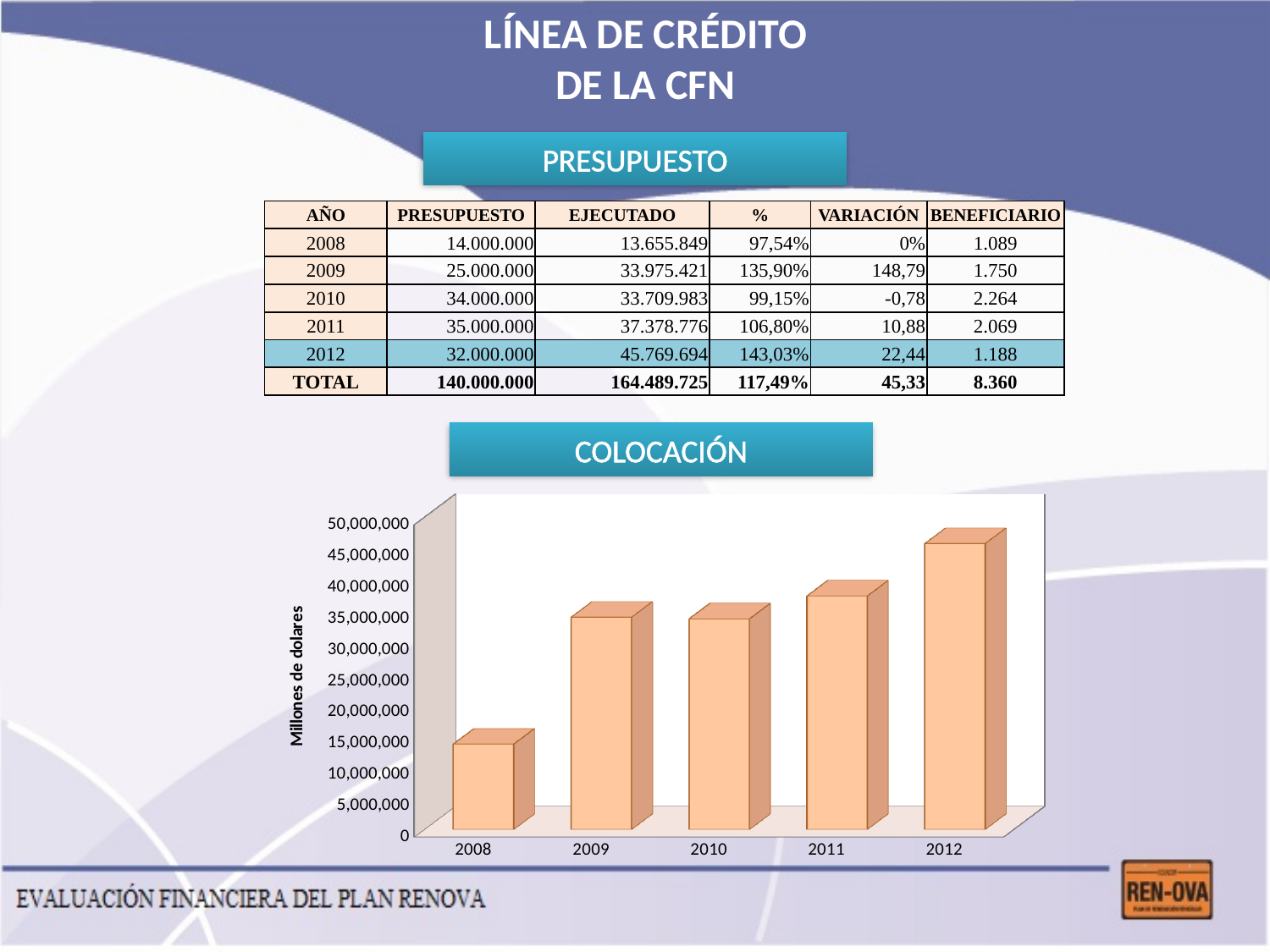
In the COLOCACIÓN chart, is the bar for 2011 greater or less than 40,000,000? less What kind of chart is shown under the COLOCACIÓN heading? bar chart What is the label on the vertical axis of the COLOCACIÓN chart? Millones de dolares In the COLOCACIÓN chart, is the bar for 2012 greater or less than 40,000,000? greater In the COLOCACIÓN chart, which bar is taller, 2008 or 2009? 2009 In the COLOCACIÓN chart, is the bar for 2009 greater or less than 30,000,000? greater Which year has the shortest bar in the COLOCACIÓN chart? 2008 In the COLOCACIÓN chart, which bar is taller, 2011 or 2012? 2012 How many years are plotted on the x axis of the COLOCACIÓN chart? 5 Which year has the tallest bar in the COLOCACIÓN chart? 2012 Overall, do the bars in the COLOCACIÓN chart rise or fall from 2008 to 2012? rise